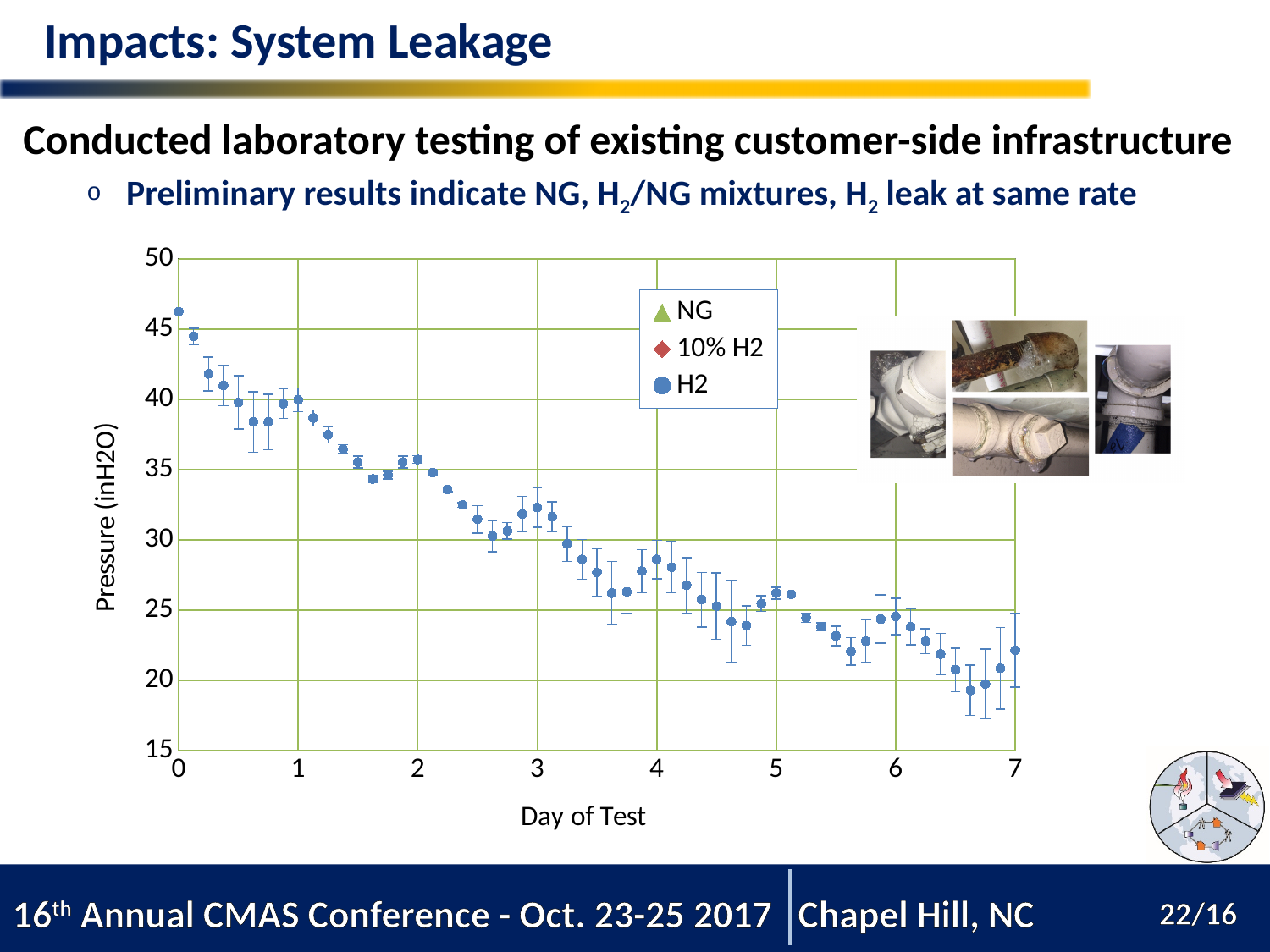
Is the pressure value at day 6 greater or less than 30? less Do the plotted pressure values rise or fall as the day of test increases? fall What is the label of the vertical axis of the chart? Pressure (inH2O) Is the pressure value at day 1 greater or less than 45? less Is the pressure value at day 3 greater or less than 30? greater At which day of test does the highest pressure value occur? 0 What kind of chart is shown on the slide? scatter chart What are the three series named in the chart legend? NG, 10% H2, H2 How many series does the chart legend list? 3 Which is larger, the pressure value at day 0 or the pressure value at day 7? day 0